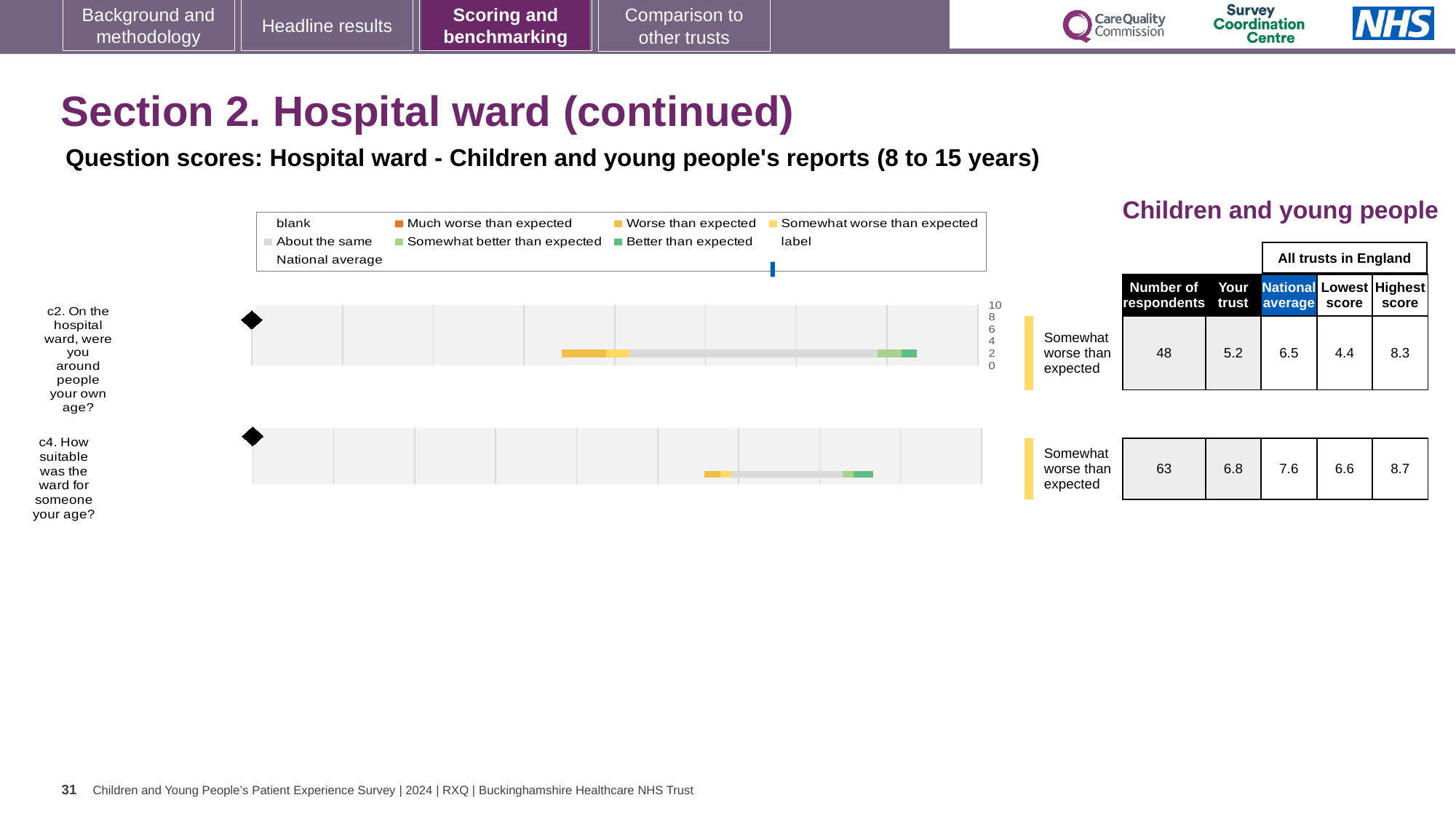
Is the 'Your trust' score for question c2 greater or less than 6? less What is the difference between the highest score and the lowest score across all trusts in England for question c2? 3.9 What benchmark category is shown for question c4? Somewhat worse than expected By how much is the national average higher than the 'Your trust' score for question c4? 0.8 How many respondents answered question c2? 48 In the legend, what does the dark green colour represent? Better than expected What is the national average score for question c4 (How suitable was the ward for someone your age?)? 7.6 Which question has the higher 'Highest score' among all trusts in England? c4 How many questions (bars) are plotted on the chart? 2 Which question has the higher 'Your trust' score, c2 or c4? c4 What kind of chart is used to show the question scores on this slide? bar chart What is the 'Your trust' score for question c2 (On the hospital ward, were you around people your own age?)? 5.2